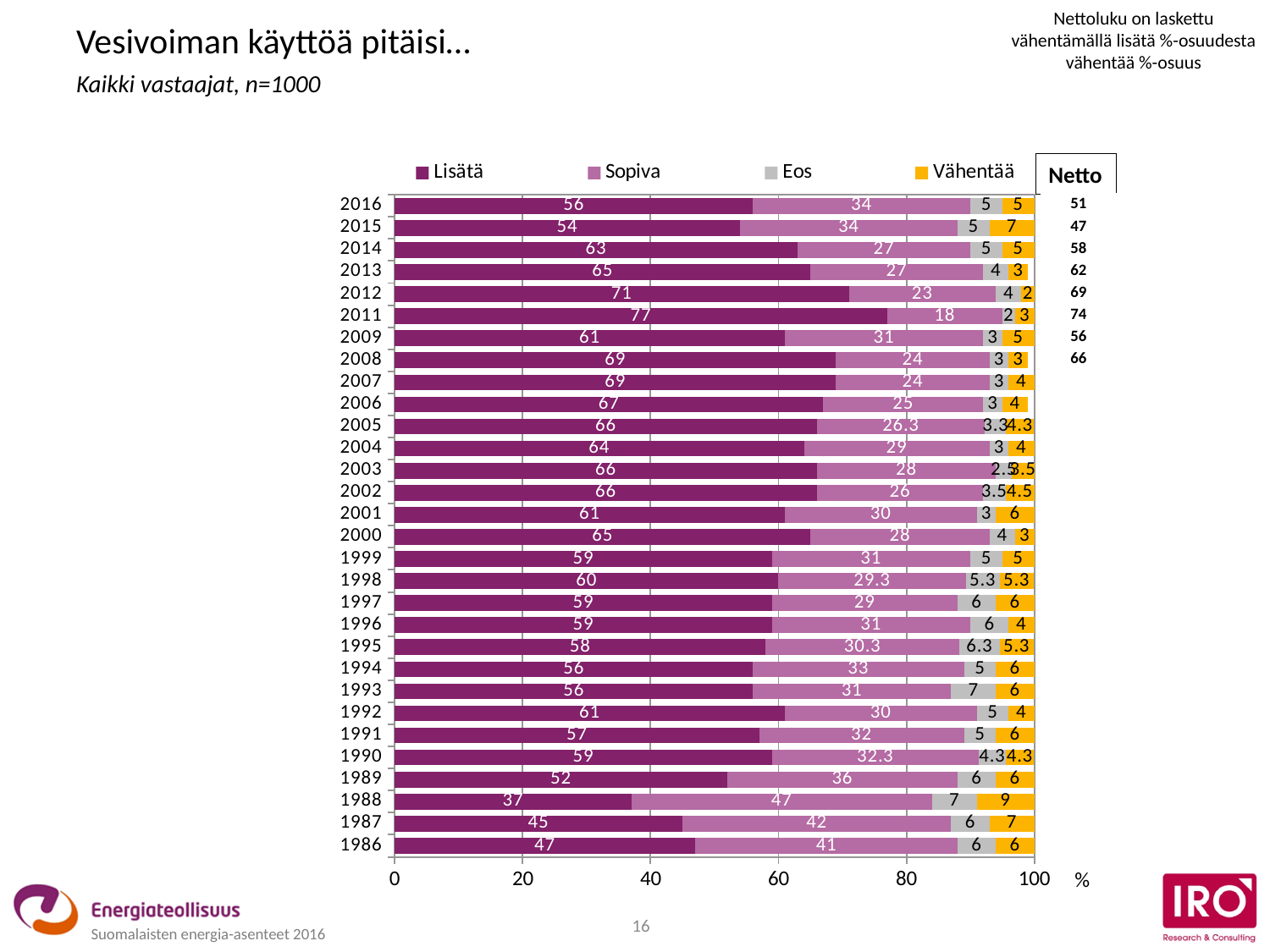
What is the Lisätä value for 2016? 56 How many years are shown on the chart? 30 What is the total of the stacked bar for 2016? 100 Which year has the lowest Lisätä value? 1988 Which year has the highest Lisätä value? 2011 What is the Eos value for 1993? 7 How many series does the legend list? 4 What is the Vähentää value for 1988? 9 Which year has the larger Sopiva value, 2016 or 2014? 2016 What kind of chart is shown on the slide? Stacked bar chart What is the difference between the Lisätä values for 2011 and 2016? 21 What is the Sopiva value for 1988? 47